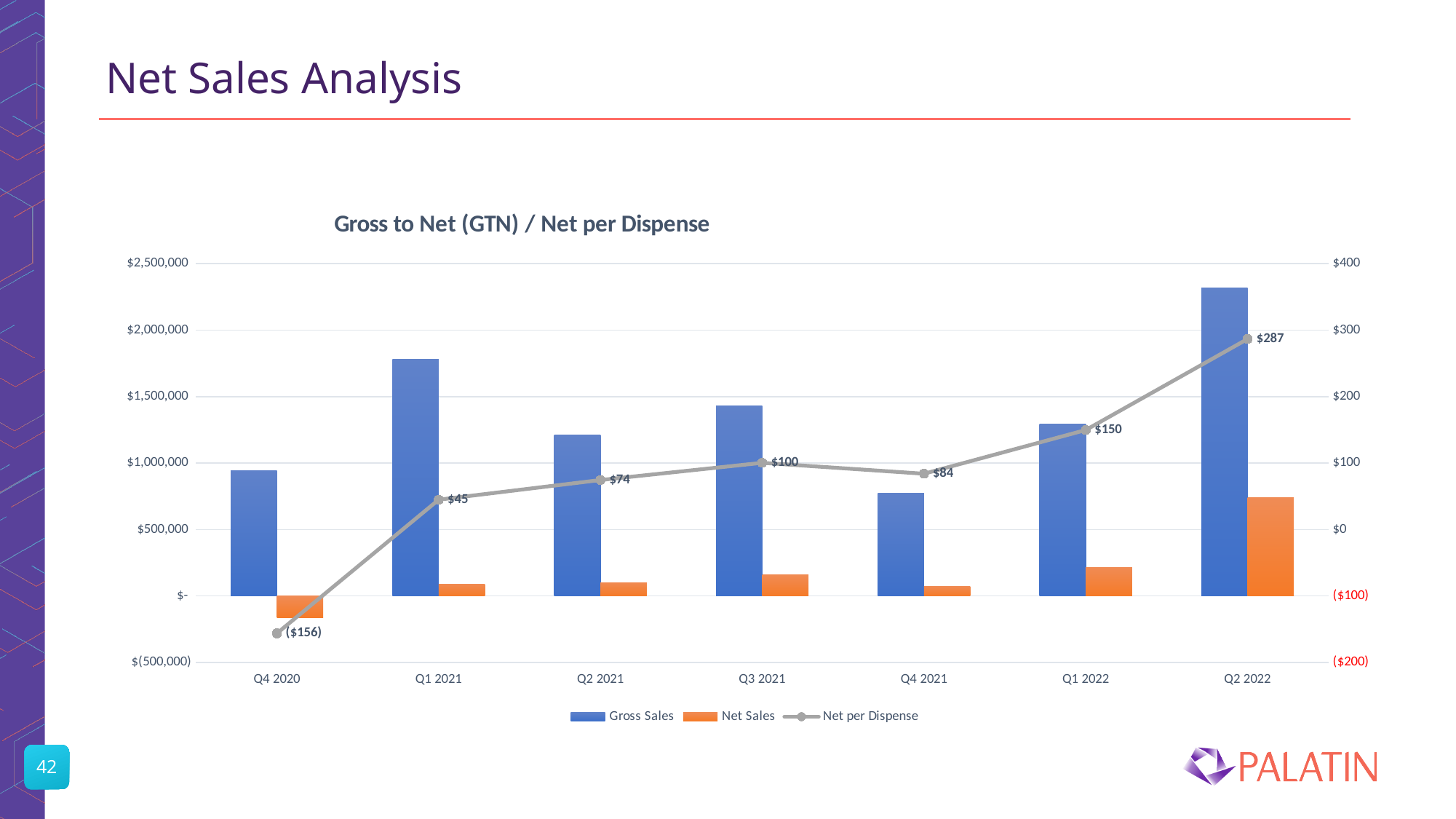
Which quarter has the higher Net per Dispense, Q3 2021 or Q4 2021? Q3 2021 What is the Net per Dispense value for Q3 2021? $100 Which quarter has the highest Net per Dispense? Q2 2022 Is the Gross Sales value for Q4 2021 greater or less than $1,000,000? less Is the Gross Sales value for Q2 2022 greater or less than $2,000,000? greater What is the difference in Net per Dispense between Q1 2022 and Q3 2021? $50 What is the Net per Dispense value for Q4 2020? ($156) How many quarters are shown on the x axis? 7 What is the title of the chart? Gross to Net (GTN) / Net per Dispense Which quarter has the lowest Net per Dispense? Q4 2020 How many series does the legend list? 3 What is the Net per Dispense value for Q2 2022? $287